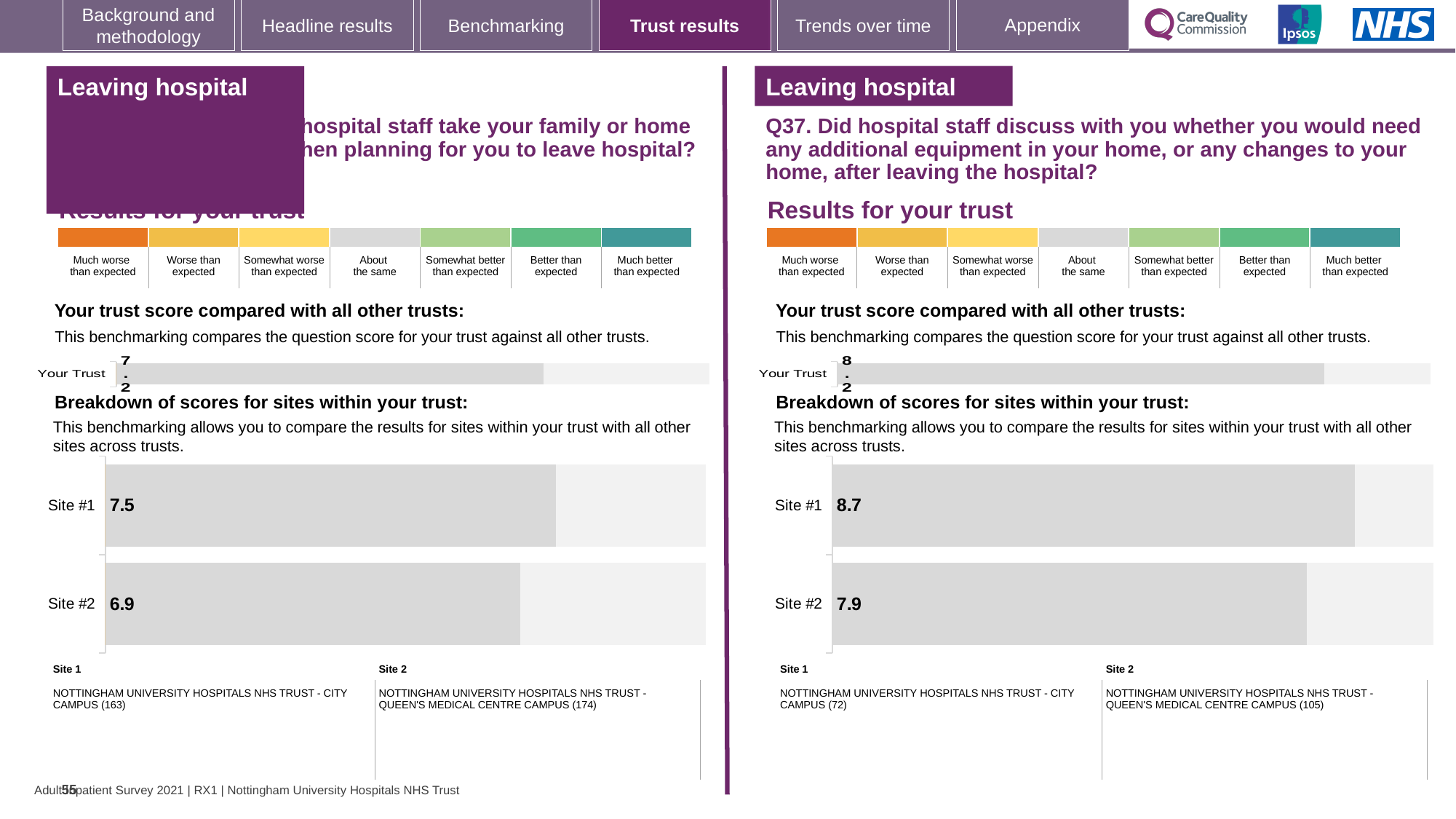
On the right-hand chart (Q37), what is the score for Site #1? 8.7 What type of chart is used to show the breakdown of scores for sites on the right-hand side (Q37)? Bar chart On the left-hand chart, what is the score for Site #1? 7.5 On the right-hand chart (Q37), how many sites are shown in the breakdown of scores? 2 On the right-hand chart (Q37), which site has the lower score? Site #2 On the right-hand chart (Q37), what is the difference between the Site #1 and Site #2 scores? 0.8 On the right-hand chart (Q37), what is the score for Site #2? 7.9 On the left-hand chart, what is the 'Your Trust' score? 7.2 On the left-hand chart, what is the difference between the Site #1 and Site #2 scores? 0.6 On the right-hand chart (Q37), what is the 'Your Trust' score? 8.2 On the left-hand chart, which site has the higher score? Site #1 On the left-hand chart, what is the score for Site #2? 6.9